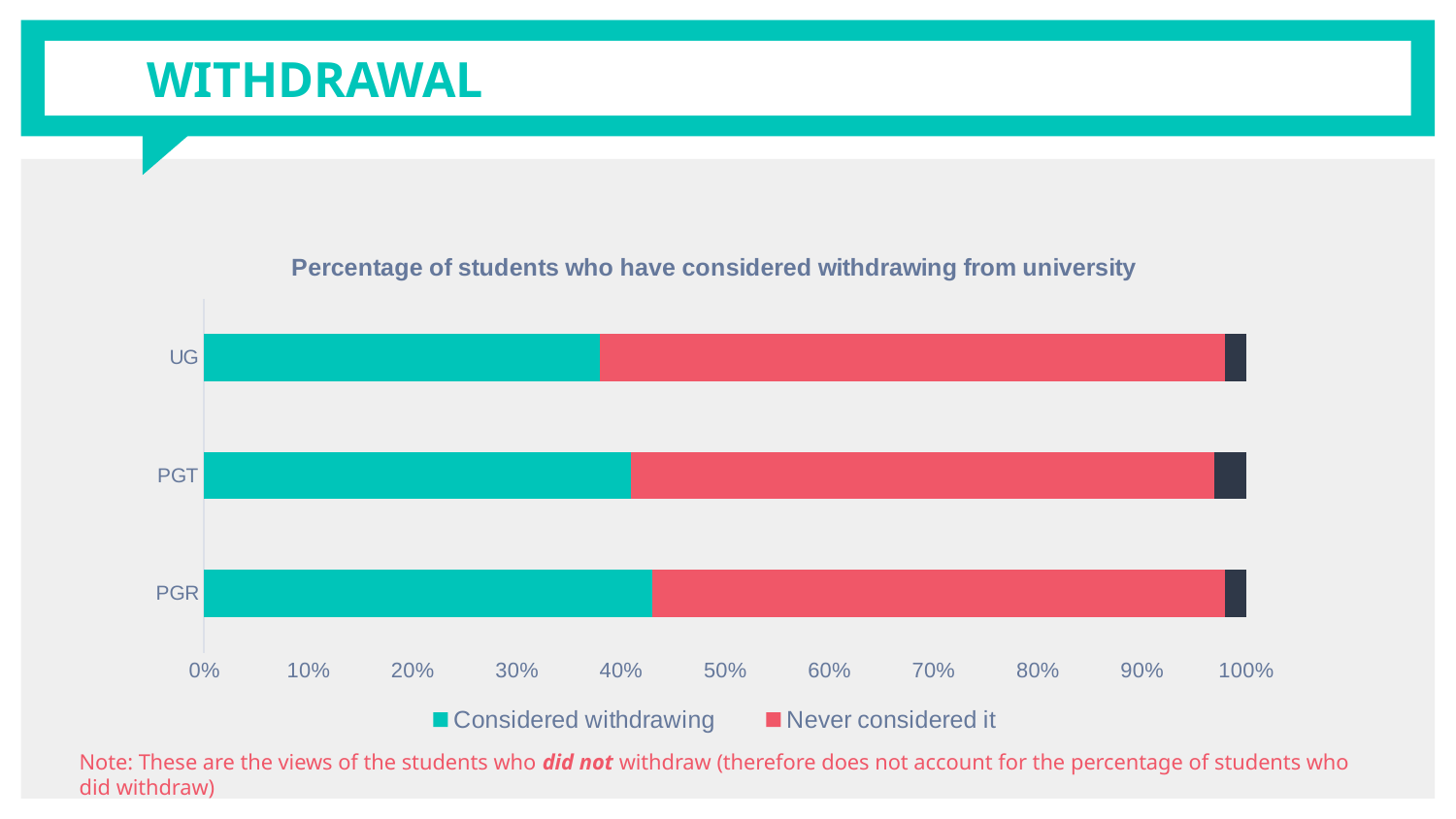
What is the title of the chart? Percentage of students who have considered withdrawing from university How many series does the chart legend list? 2 Which student group has the lowest 'Considered withdrawing' share? UG Which student group has the largest 'Never considered it' segment? UG Is the 'Never considered it' segment for UG greater or less than 50%? greater What kind of chart is shown on the slide? Stacked bar chart Is the 'Considered withdrawing' value for UG greater or less than 40%? less Is the 'Considered withdrawing' value for PGR greater or less than 40%? greater How many student groups (categories) are shown on the chart? 3 Which student group has the highest 'Considered withdrawing' share? PGR Which has a larger 'Considered withdrawing' share, UG or PGR? PGR Which colour represents 'Considered withdrawing' in the chart? Teal (green)